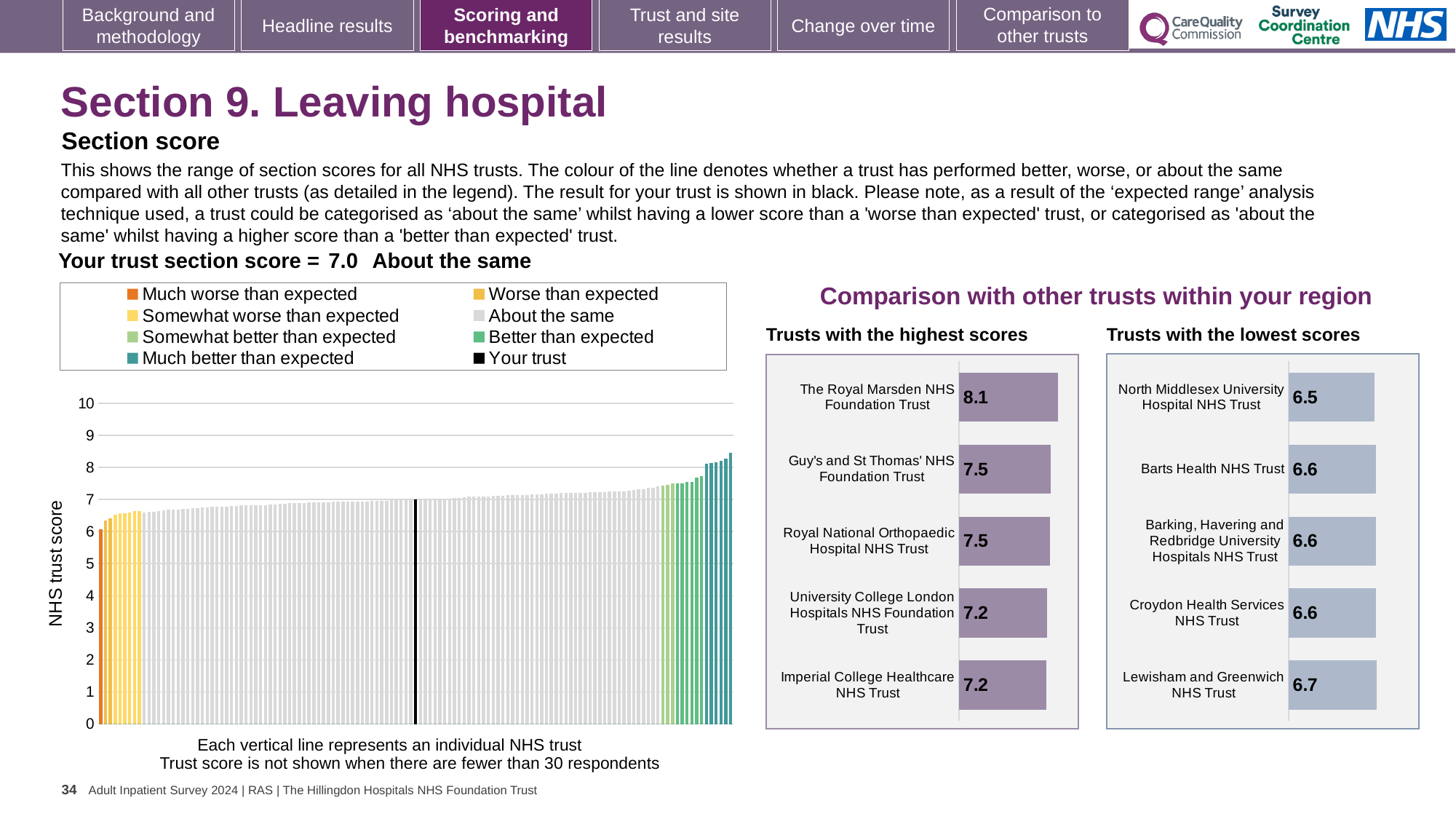
How many entries does the legend of the main NHS trust score chart on the left list? 8 In the 'Trusts with the lowest scores' chart, what is the score for Croydon Health Services NHS Trust? 6.6 In the 'Trusts with the lowest scores' chart, which has the larger score: Lewisham and Greenwich NHS Trust or Barts Health NHS Trust? Lewisham and Greenwich NHS Trust In the 'Trusts with the lowest scores' chart, what is the difference between the scores of Lewisham and Greenwich NHS Trust and North Middlesex University Hospital NHS Trust? 0.2 How many trusts are shown in the 'Trusts with the highest scores' chart? 5 In the 'Trusts with the highest scores' chart, which trust has the highest score? The Royal Marsden NHS Foundation Trust In the 'Trusts with the lowest scores' chart, which trust has the lowest score? North Middlesex University Hospital NHS Trust In the 'Trusts with the lowest scores' chart, what is the score for North Middlesex University Hospital NHS Trust? 6.5 In the main NHS trust score chart on the left, what is the section score for your trust? 7.0 What kind of chart is the 'Trusts with the lowest scores' chart? Bar chart In the 'Trusts with the highest scores' chart, what is the score for The Royal Marsden NHS Foundation Trust? 8.1 In the 'Trusts with the highest scores' chart, what is the difference between the scores of The Royal Marsden NHS Foundation Trust and Imperial College Healthcare NHS Trust? 0.9